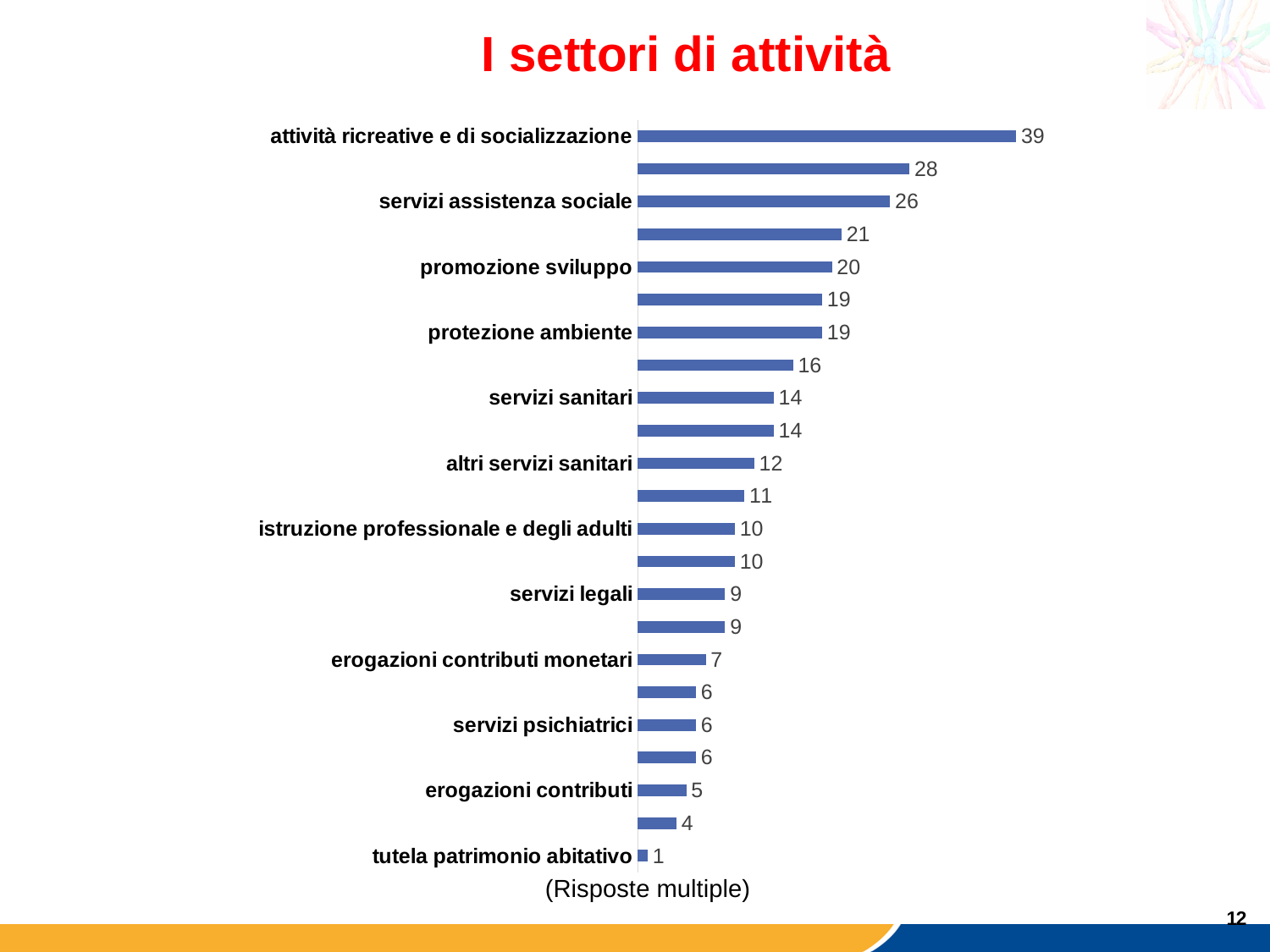
What is the difference between the values for promozione sviluppo and servizi sanitari? 6 What is the difference between the values for attività ricreative e di socializzazione and servizi assistenza sociale? 13 Which category has the highest value? attività ricreative e di socializzazione Which is larger, the value for altri servizi sanitari or the value for servizi legali? altri servizi sanitari What is the title of the slide? I settori di attività What is the value for servizi assistenza sociale? 26 What is the value for attività ricreative e di socializzazione? 39 What is the value for erogazioni contributi monetari? 7 How many bars are plotted in the chart? 23 What is the value for protezione ambiente? 19 Which category has the lowest value? tutela patrimonio abitativo What kind of chart is shown on the slide? bar chart